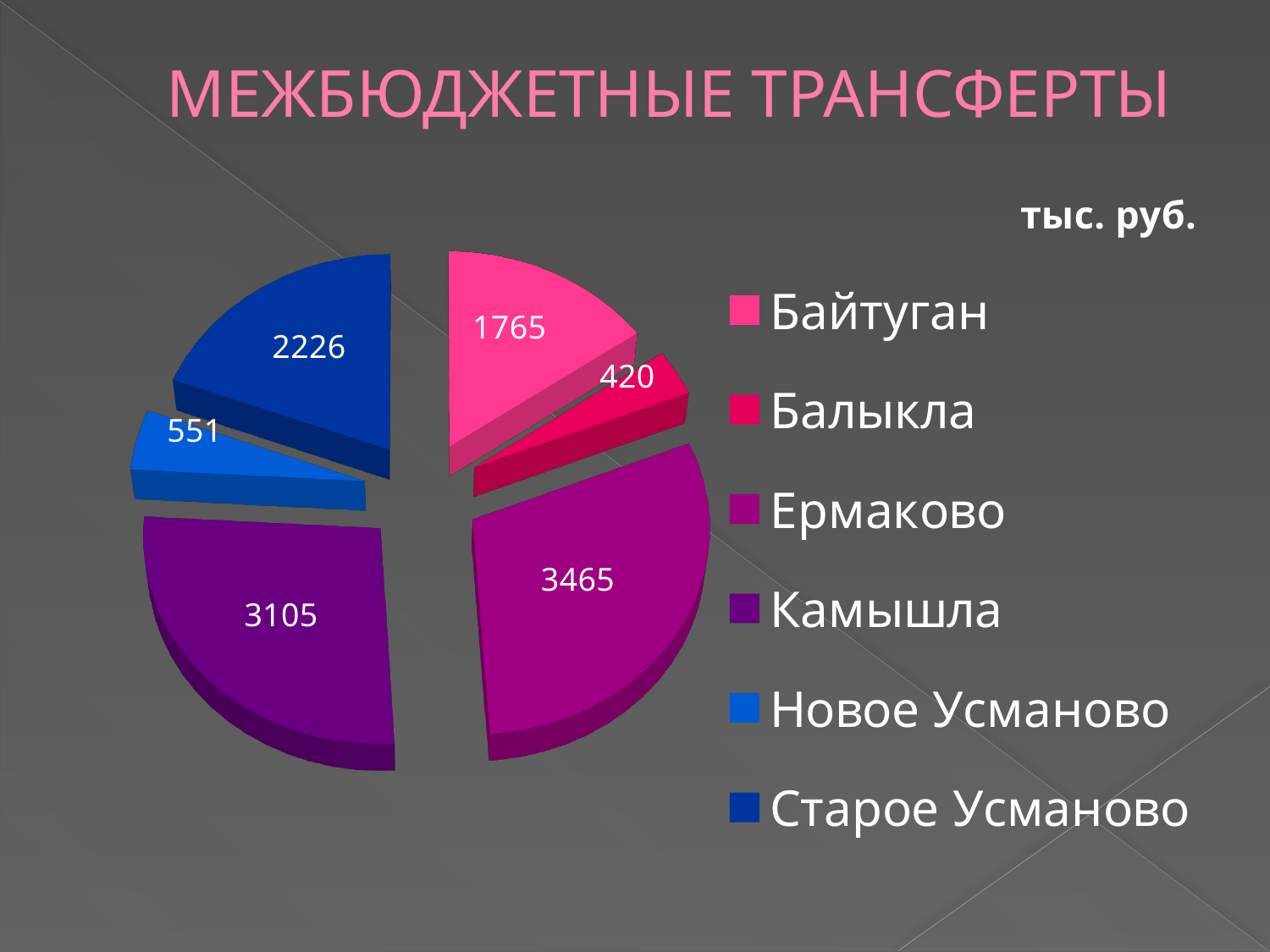
What is the value for Новое Усманово? 551 Which category has the largest value? Ермаково What is the value for Ермаково? 3465 How many categories does the pie chart have? 6 What is the value for Байтуган? 1765 What is the value for Старое Усманово? 2226 What is the difference between the values for Ермаково and Камышла? 360 Which is larger, the value for Новое Усманово or the value for Балыкла? Новое Усманово What is the difference between the values for Старое Усманово and Байтуган? 461 Which category has the smallest value? Балыкла What kind of chart is shown on the slide? pie chart What unit is indicated for the values on the slide? тыс. руб.